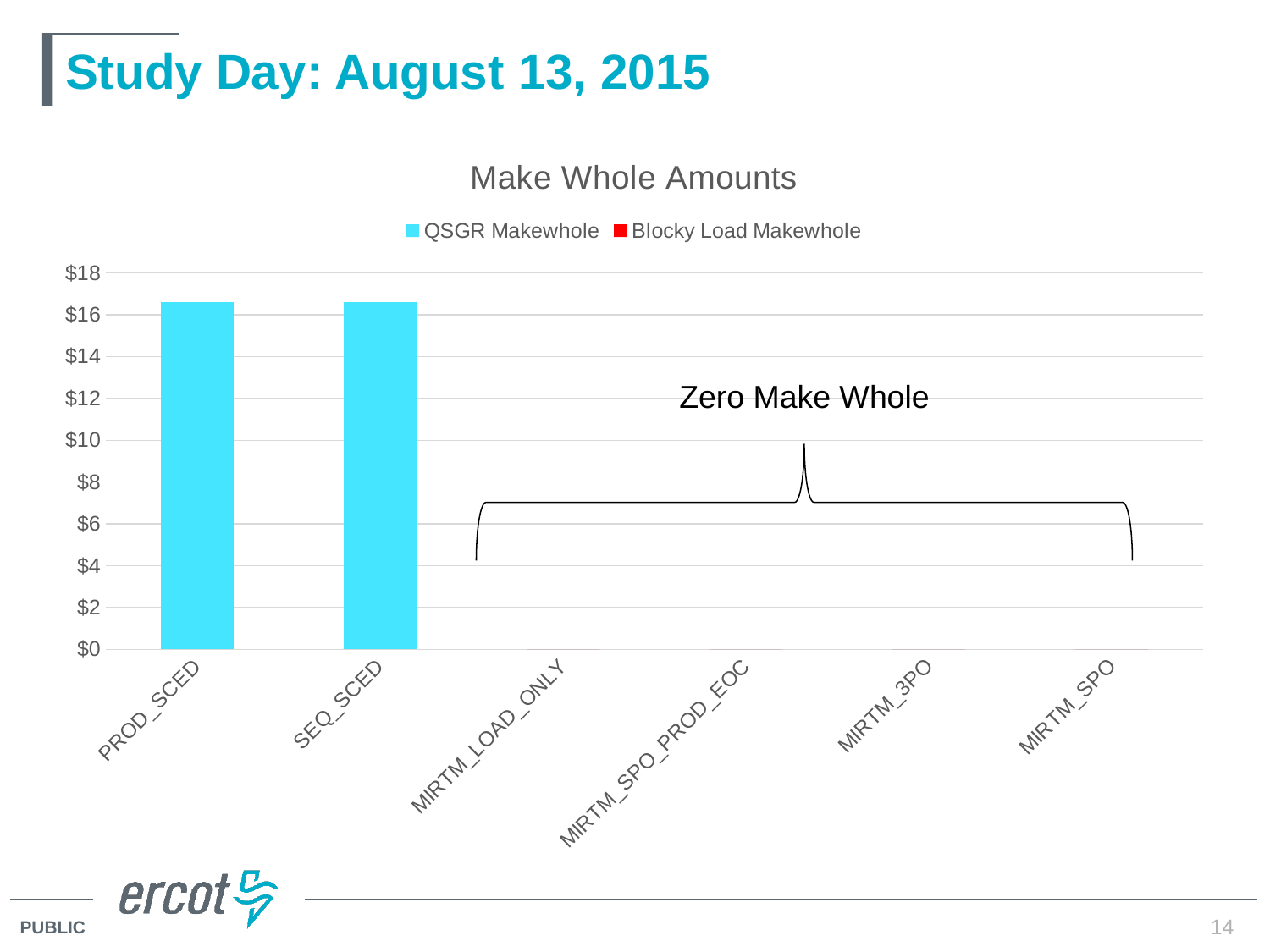
What is the highest value shown on the y axis of the chart? $18 Which series in the legend is shown in red? Blocky Load Makewhole Which category has a larger QSGR Makewhole value, PROD_SCED or MIRTM_3PO? PROD_SCED How many categories are shown on the x axis of the chart? 6 What kind of chart is shown on the slide? bar chart What annotation text is written over the MIRTM categories in the chart? Zero Make Whole Is the QSGR Makewhole value for SEQ_SCED greater or less than $10? greater How many series does the chart legend list? 2 Is the QSGR Makewhole value for SEQ_SCED greater or less than $18? less Is the QSGR Makewhole value for PROD_SCED greater or less than $14? greater Which category has a larger QSGR Makewhole value, MIRTM_SPO or SEQ_SCED? SEQ_SCED